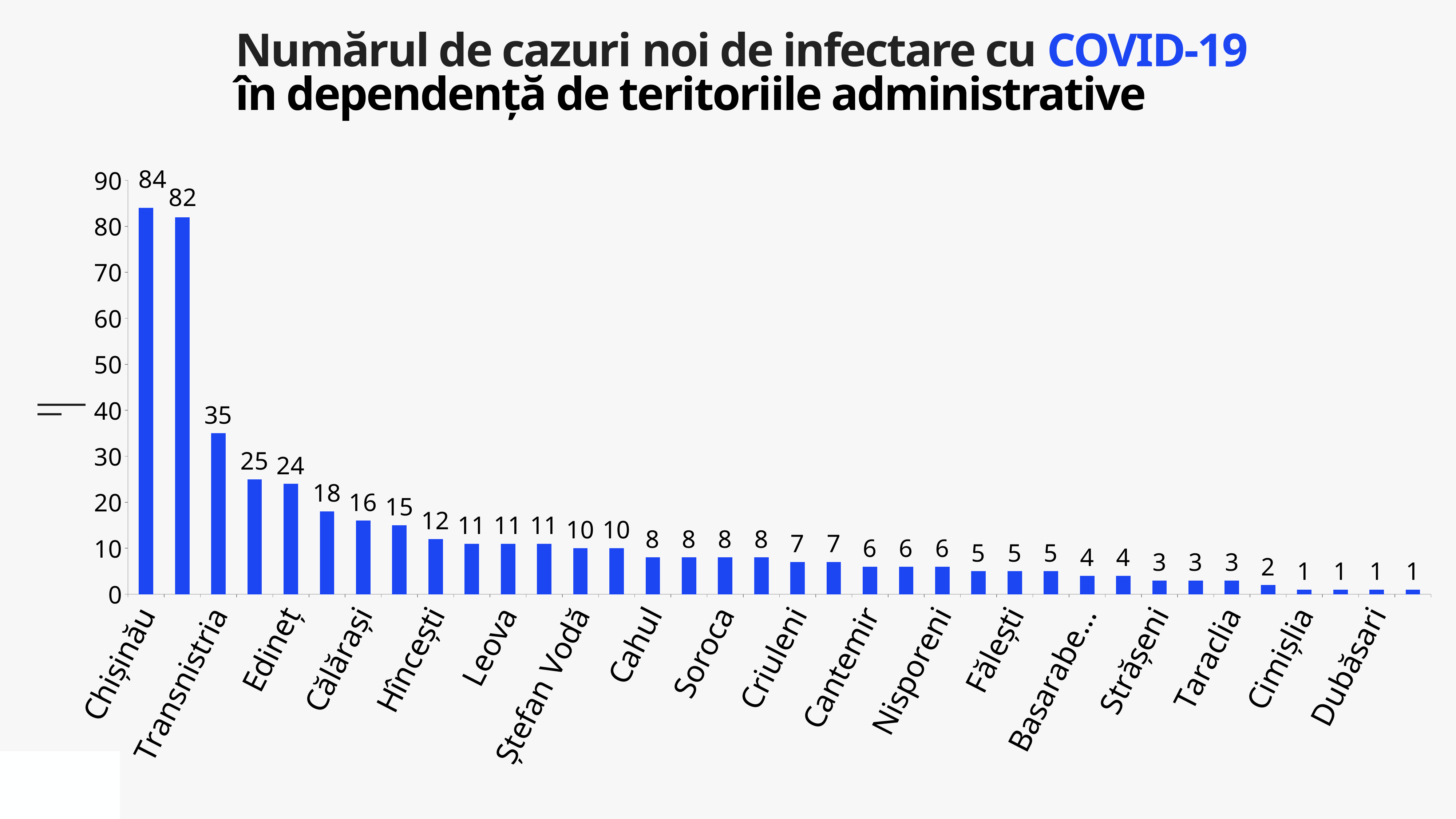
What is the lowest value shown on the chart? 1 What is the difference between the two tallest bars? 2 How many bars are plotted on the chart? 36 Which is larger, the value for Chișinău or the value for Transnistria? Chișinău What kind of chart is shown? bar chart Which category has the highest value? Chișinău What is the highest value shown on the chart? 84 Is the value for Dubăsari greater or less than 10? less Is the value for Chișinău greater or less than 80? greater What is the value for Chișinău? 84 Do the values rise or fall from left to right along the x axis? fall What is the maximum value shown on the y axis? 90